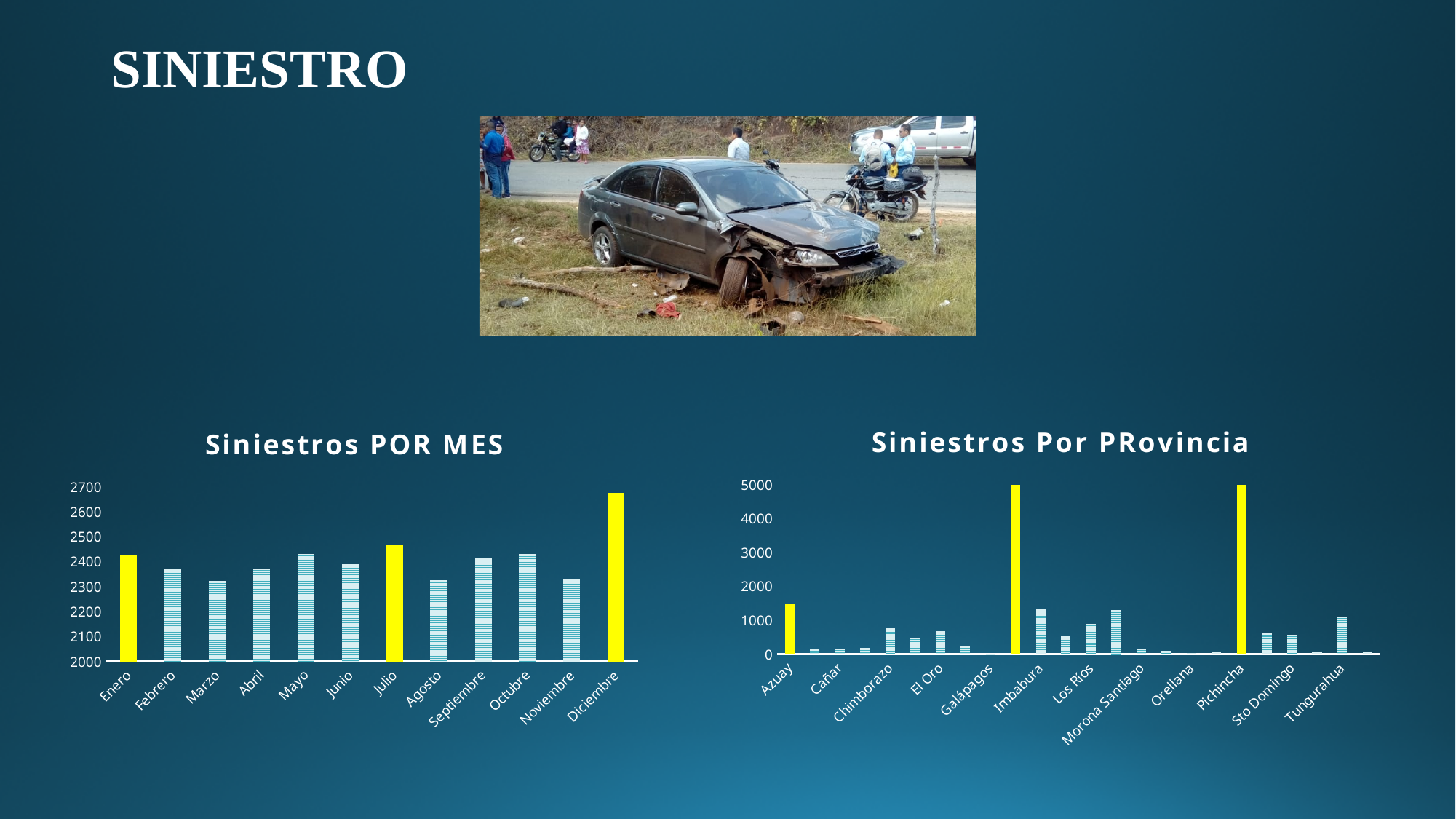
In the "Siniestros POR MES" chart, is the value for Marzo greater or less than 2400? less In the "Siniestros POR MES" chart, how many months are shown on the x axis? 12 What kind of chart is "Siniestros POR MES"? bar chart In the "Siniestros POR MES" chart, which is larger, the value for Diciembre or the value for Julio? Diciembre In the "Siniestros POR MES" chart, is the value for Diciembre greater or less than 2600? greater In the "Siniestros Por PRovincia" chart, which is larger, the value for Azuay or the value for Cañar? Azuay In the "Siniestros Por PRovincia" chart, is the value for Cañar greater or less than 1000? less In the "Siniestros POR MES" chart, which is larger, the value for Mayo or the value for Febrero? Mayo What colour are the highlighted bars in the "Siniestros POR MES" chart? yellow In the "Siniestros POR MES" chart, which month has the highest value? Diciembre